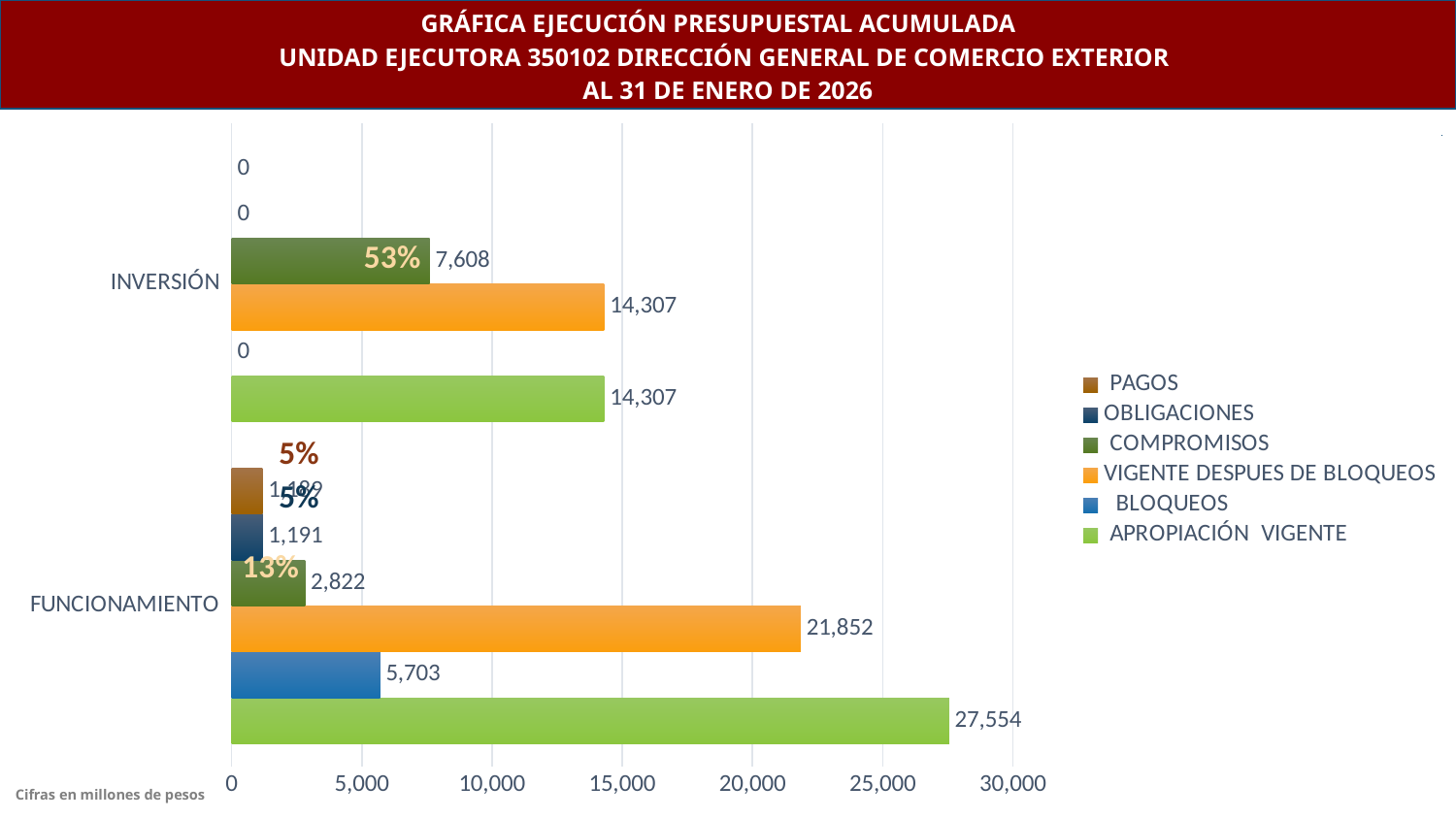
What is the BLOQUEOS value for FUNCIONAMIENTO? 5,703 How many series does the legend list? 6 What percentage label is shown on the COMPROMISOS bar for FUNCIONAMIENTO? 13% What is the difference between APROPIACIÓN VIGENTE and VIGENTE DESPUES DE BLOQUEOS for FUNCIONAMIENTO? 5,702 What is the APROPIACIÓN VIGENTE value for FUNCIONAMIENTO? 27,554 How many categories are shown on the vertical axis? 2 Which series has the highest value for FUNCIONAMIENTO? APROPIACIÓN VIGENTE Which category has the higher VIGENTE DESPUES DE BLOQUEOS value, INVERSIÓN or FUNCIONAMIENTO? FUNCIONAMIENTO What is the VIGENTE DESPUES DE BLOQUEOS value for INVERSIÓN? 14,307 What unit note is printed at the bottom left of the chart? Cifras en millones de pesos What kind of chart is shown on the slide? bar chart What is the COMPROMISOS value for INVERSIÓN? 7,608